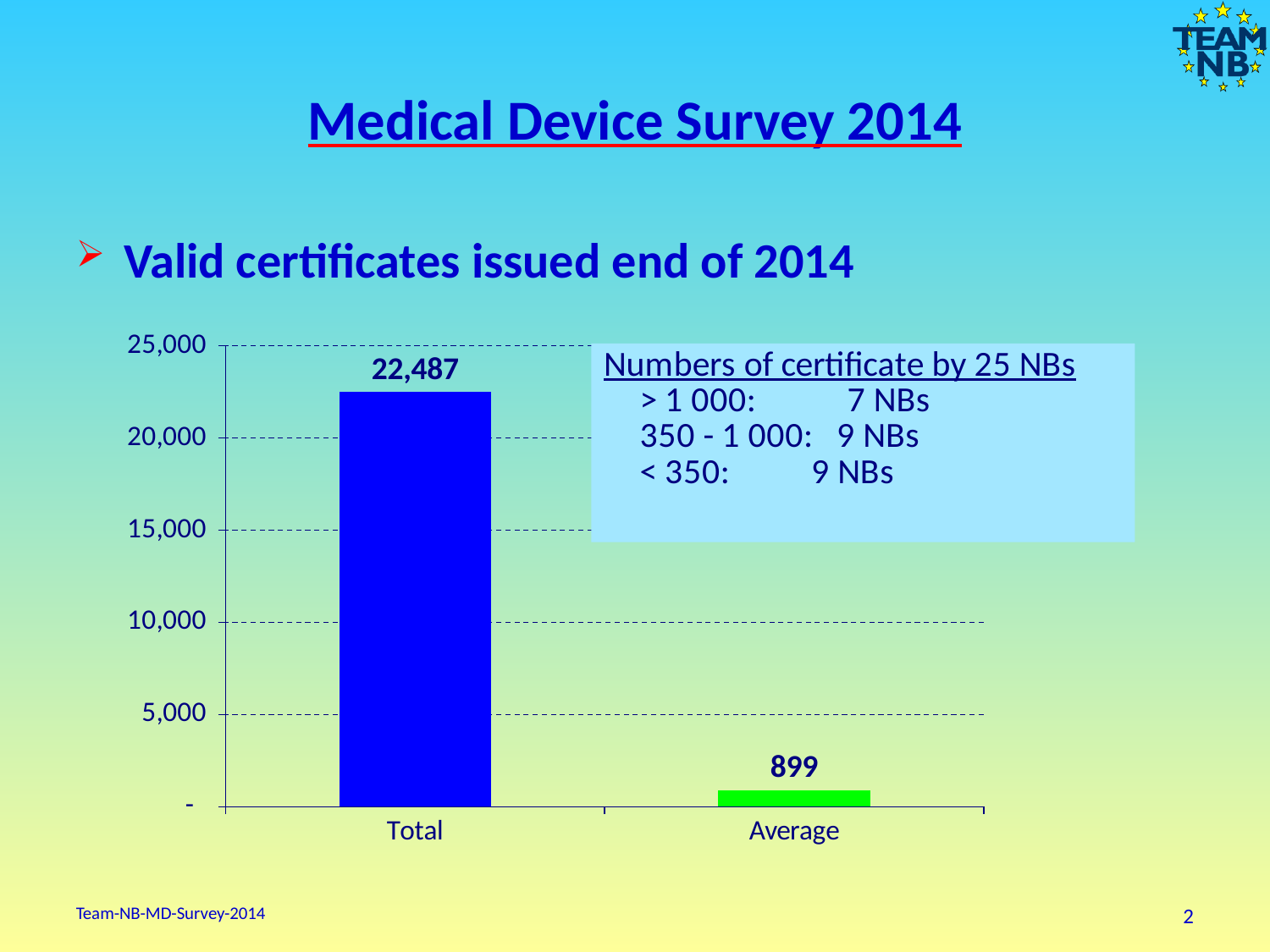
Which category has the lowest value? Average How many categories are shown on the x axis? 2 Which category has the highest value? Total What kind of chart is shown on the slide? bar chart What is the highest value shown on the y axis? 25,000 What is the value of the Total bar? 22,487 What is the difference between the Total and Average values? 21,588 What is the value of the Average bar? 899 Is the value for Total greater or less than 20,000? greater What colour is the Average bar? green Which is larger, the Total bar or the Average bar? Total Is the value for Average greater or less than 5,000? less